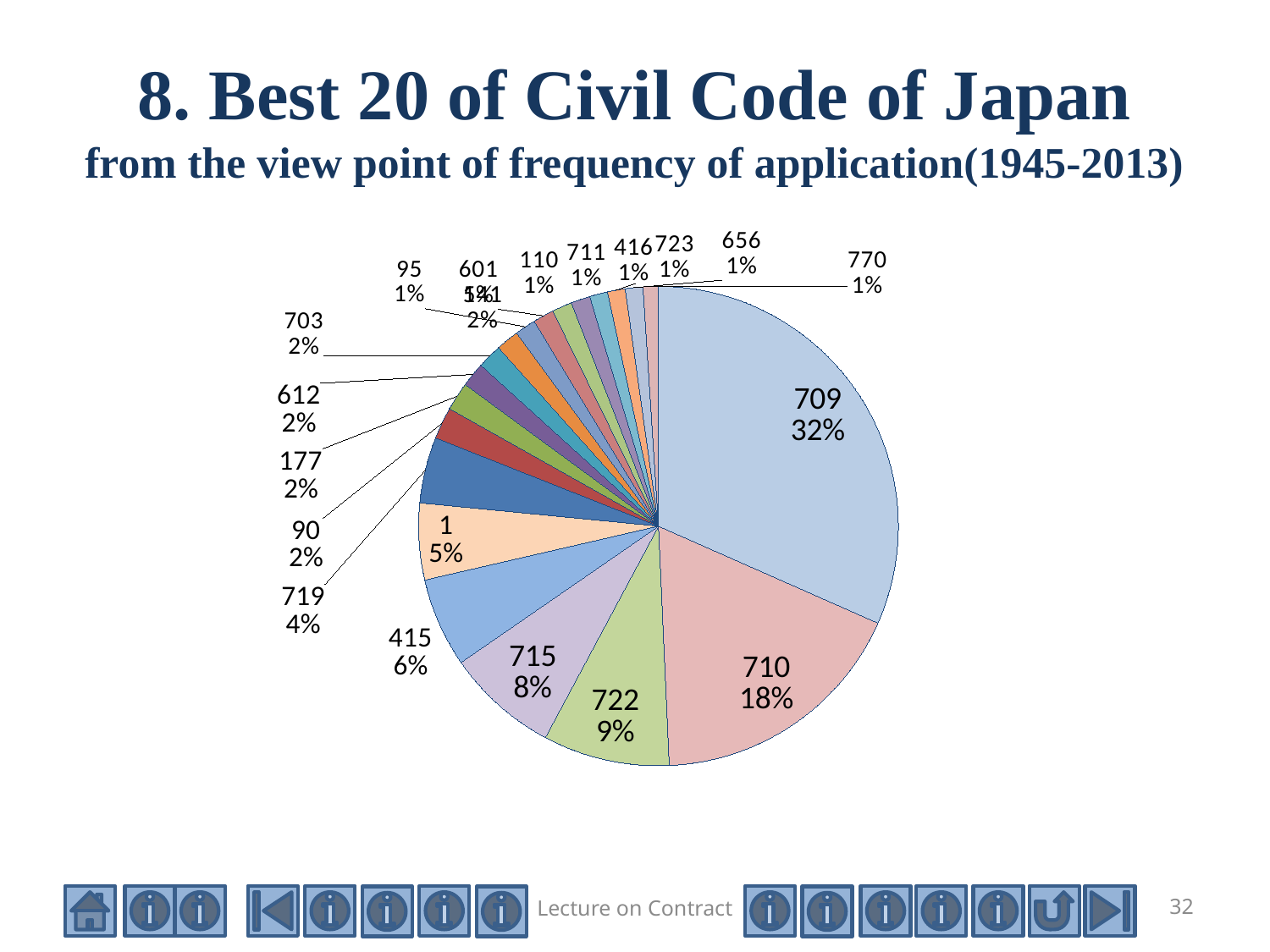
What percentage share does article 709 have? 32% Which has the larger share, article 709 or article 710? 709 What period does the chart title say the frequency of application covers? 1945-2013 What percentage is shown for article 415? 6% Which article has the largest share of the pie? 709 What percentage is shown for article 719? 4% What kind of chart is shown on the slide? pie chart What percentage is shown for article 710? 18% What percentage is shown for article 715? 8% Which has the larger share, article 415 or article 1? 415 What percentage is shown for article 722? 9% What is the difference in percentage points between the shares of article 709 and article 710? 14 percentage points